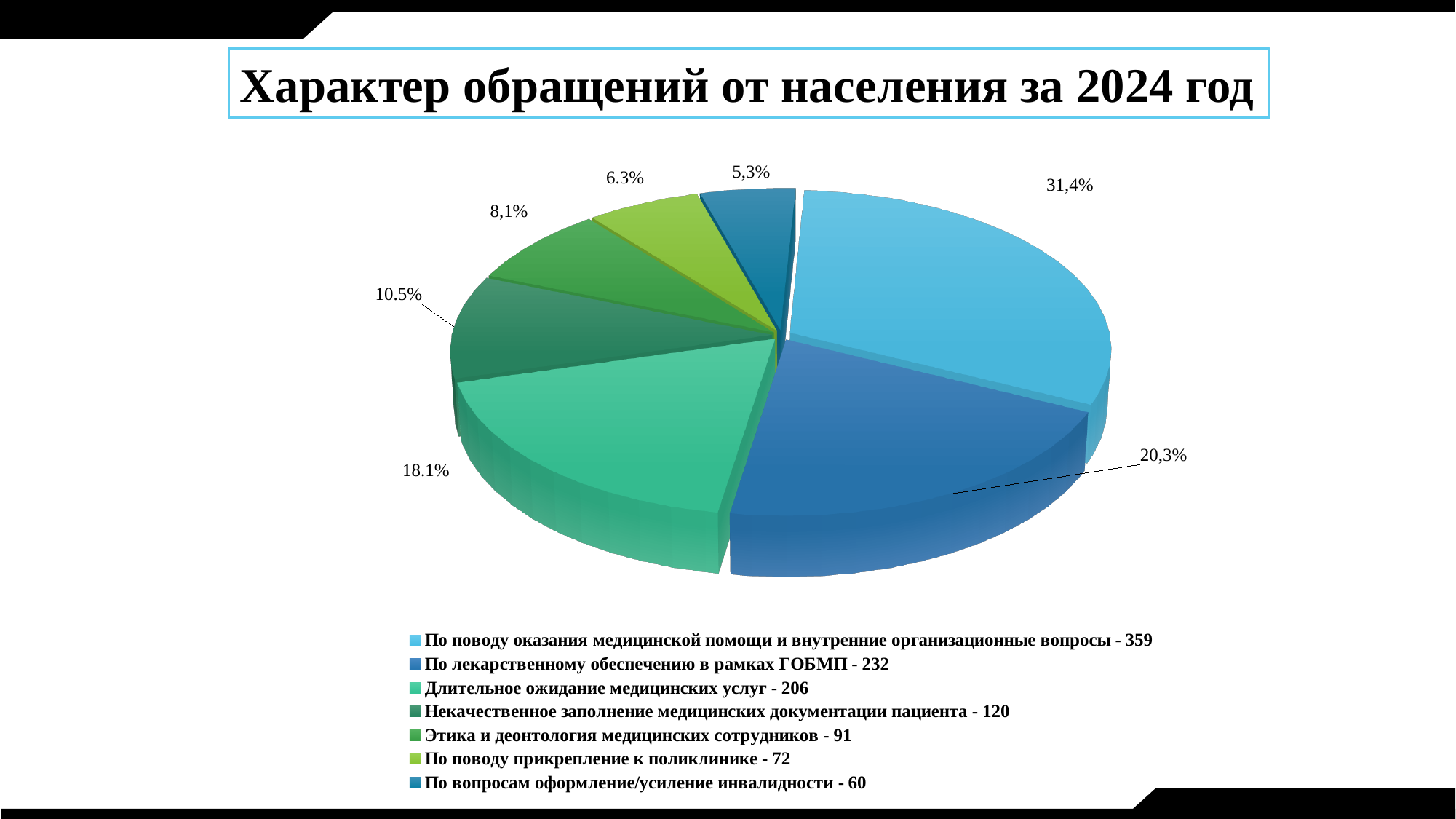
What kind of chart is shown on the slide? pie chart What share of the pie does the slice labelled 'По поводу оказания медицинской помощи и внутренние организационные вопросы' take? 31,4% According to the legend, how many appeals were about 'Этика и деонтология медицинских сотрудников'? 91 Which is larger: the number of appeals for 'По поводу прикрепление к поликлинике' or for 'По вопросам оформление/усиление инвалидности'? По поводу прикрепление к поликлинике Which category has the smallest slice of the pie? По вопросам оформление/усиление инвалидности How many slices does the pie chart have? 7 What share of the pie does the slice 'По лекарственному обеспечению в рамках ГОБМП' take? 20,3% What is the title of the chart? Характер обращений от населения за 2024 год What share of the pie does the slice 'Длительное ожидание медицинских услуг' take? 18.1% Which category has the largest slice of the pie? По поводу оказания медицинской помощи и внутренние организационные вопросы According to the legend, how many appeals were about 'Некачественное заполнение медицинских документации пациента'? 120